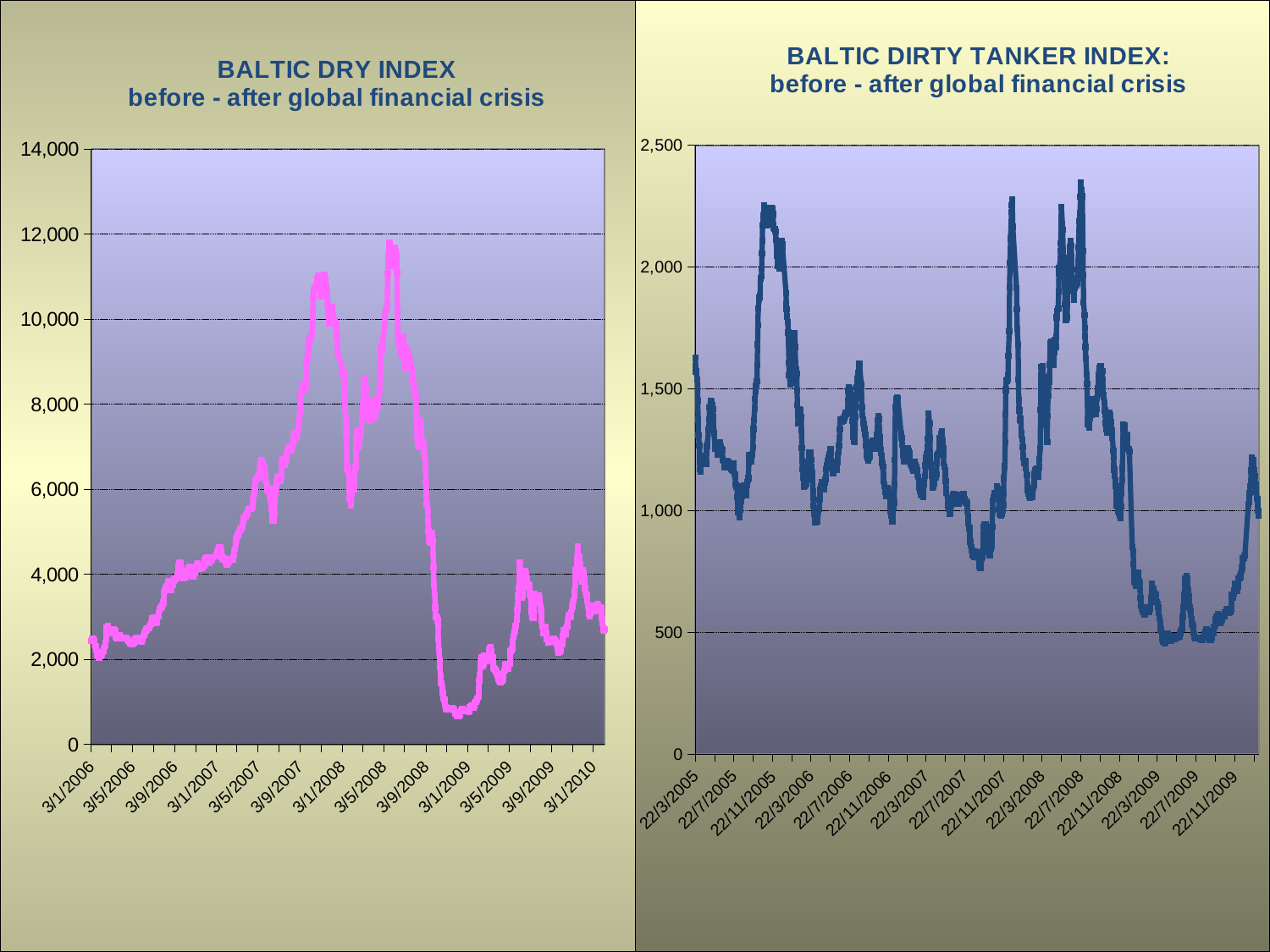
What is the highest value shown on the y-axis of the BALTIC DIRTY TANKER INDEX chart? 2,500 In the BALTIC DRY INDEX chart, is the value at 3/1/2009 greater or less than 2,000? less In the BALTIC DIRTY TANKER INDEX chart, is the value at 22/11/2005 greater or less than 2,000? greater What kind of chart is the BALTIC DIRTY TANKER INDEX chart on the right? line chart In the BALTIC DIRTY TANKER INDEX chart, is the value at 22/3/2009 greater or less than 1,000? less In the BALTIC DRY INDEX chart, does the line rise or fall between 3/1/2006 and 3/1/2008? rise What kind of chart is the BALTIC DRY INDEX chart on the left? line chart In the BALTIC DIRTY TANKER INDEX chart, does the line rise or fall between 22/11/2008 and 22/3/2009? fall In the BALTIC DRY INDEX chart, does the line rise or fall between 3/9/2008 and 3/1/2009? fall What colour is the line in the BALTIC DRY INDEX chart? pink